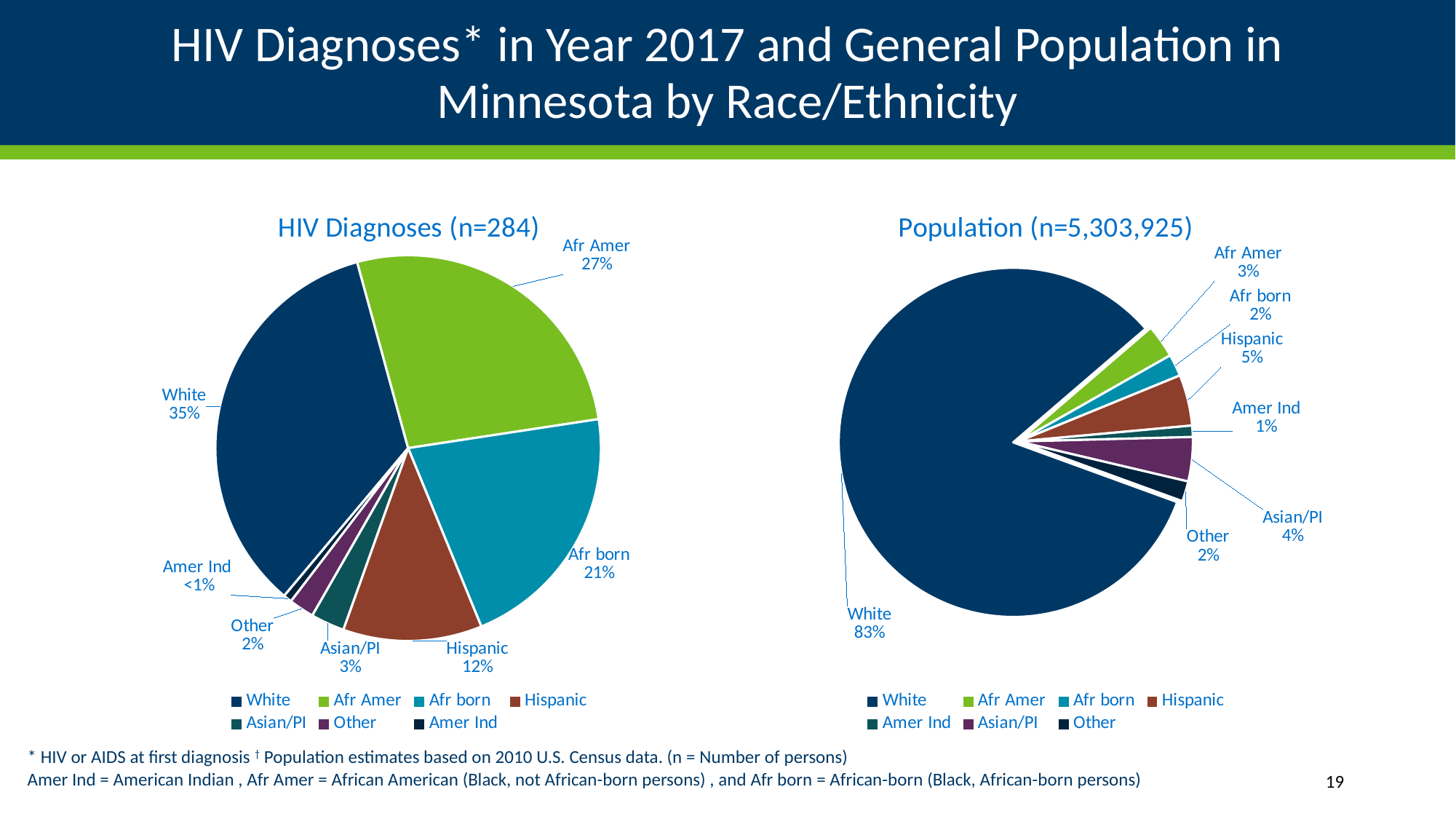
In the Population (n=5,303,925) chart, what percentage is labelled for Hispanic? 5% What kind of chart is the Population (n=5,303,925) chart? Pie chart In the HIV Diagnoses (n=284) chart, what share of the pie is White? 35% How many categories does the legend of the HIV Diagnoses (n=284) chart list? 7 In the Population (n=5,303,925) chart, which category has the smallest slice? Amer Ind In the HIV Diagnoses (n=284) chart, which category has the largest slice? White In the HIV Diagnoses (n=284) chart, what is the difference in percentage points between Afr Amer and Hispanic? 15 In the HIV Diagnoses (n=284) chart, what percentage is labelled for Afr born? 21% In the HIV Diagnoses (n=284) chart, which category has the smallest slice? Amer Ind In the Population (n=5,303,925) chart, what share of the pie is White? 83% In the Population (n=5,303,925) chart, which is larger, Asian/PI or Afr Amer? Asian/PI What is the title of the chart on the left side of the slide? HIV Diagnoses (n=284)